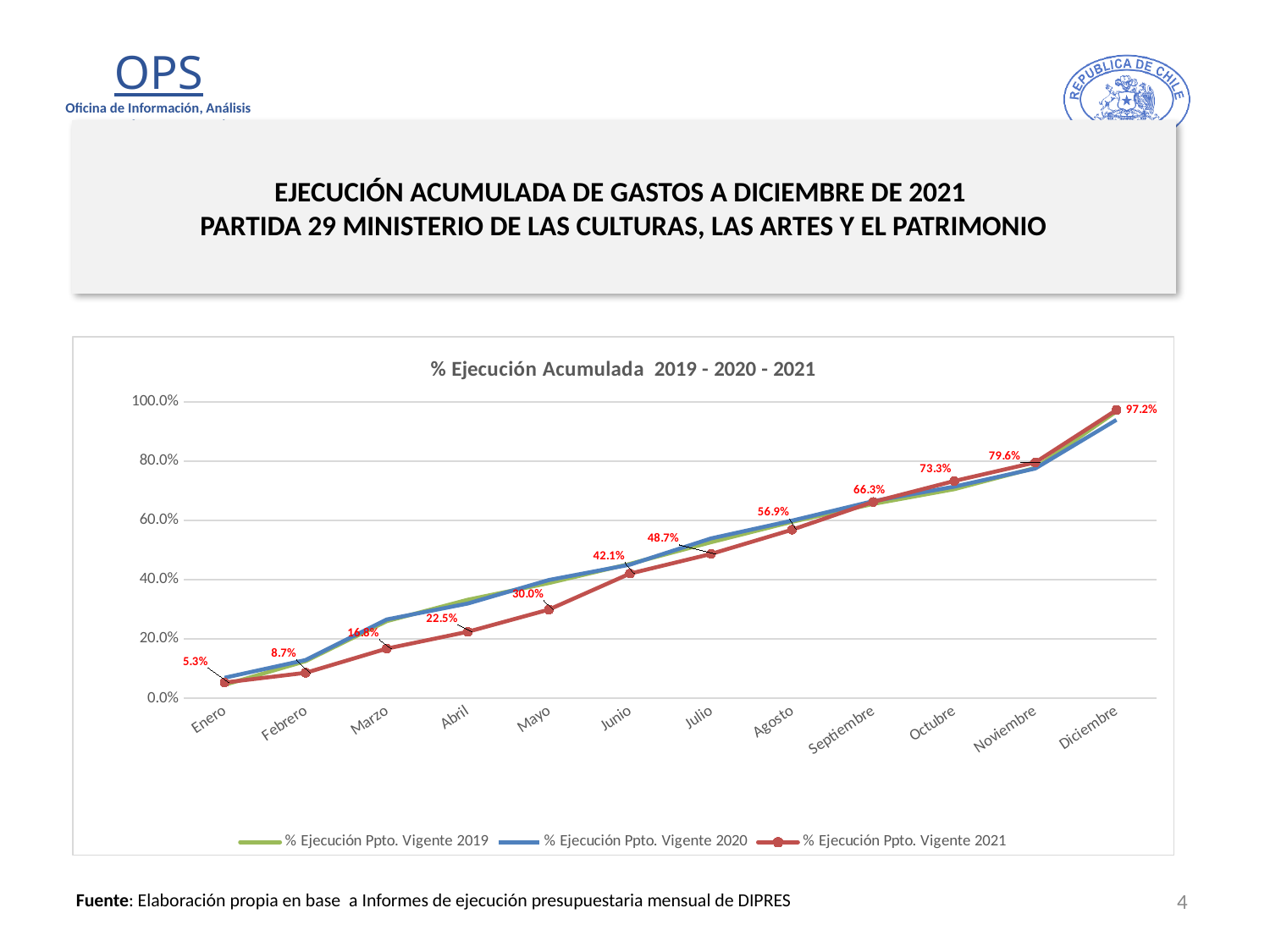
Do the values of the % Ejecución Ppto. Vigente 2021 series rise or fall from Enero to Diciembre? rise What is the value for % Ejecución Ppto. Vigente 2021 in Diciembre? 97.2% What is the value for % Ejecución Ppto. Vigente 2021 in Septiembre? 66.3% What type of chart is shown on the slide? line chart What is the value for % Ejecución Ppto. Vigente 2021 in Enero? 5.3% In which month is the % Ejecución Ppto. Vigente 2021 series highest? Diciembre How many months are shown on the x axis? 12 In which month is the % Ejecución Ppto. Vigente 2021 series lowest? Enero How many series does the legend list? 3 What is the value for % Ejecución Ppto. Vigente 2021 in Junio? 42.1% What is the chart's title? % Ejecución Acumulada 2019 - 2020 - 2021 What is the difference between the % Ejecución Ppto. Vigente 2021 values for Diciembre and Noviembre? 17.6%